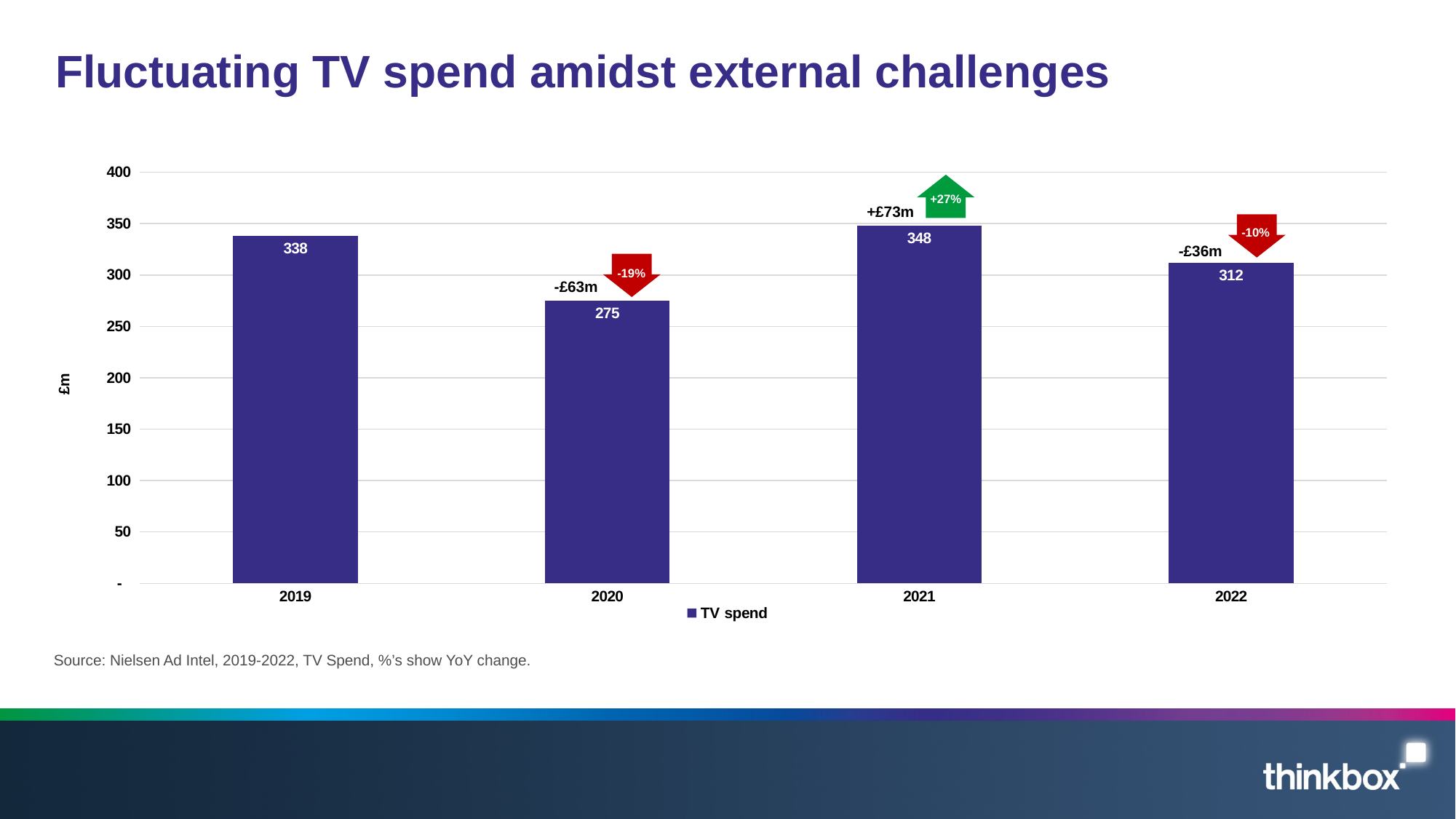
What is the year-on-year percentage change shown for 2021? +27% What is the TV spend value for 2022? 312 Which year has the lowest TV spend? 2020 What is the TV spend value for 2019? 338 How many series does the legend list? 1 How many years are shown on the x axis? 4 Which year has a larger TV spend, 2019 or 2022? 2019 What kind of chart is shown on the slide? Bar chart What is the TV spend value for 2020? 275 Which year has the highest TV spend? 2021 What is the TV spend value for 2021? 348 What is the difference in TV spend between 2021 and 2020? 73